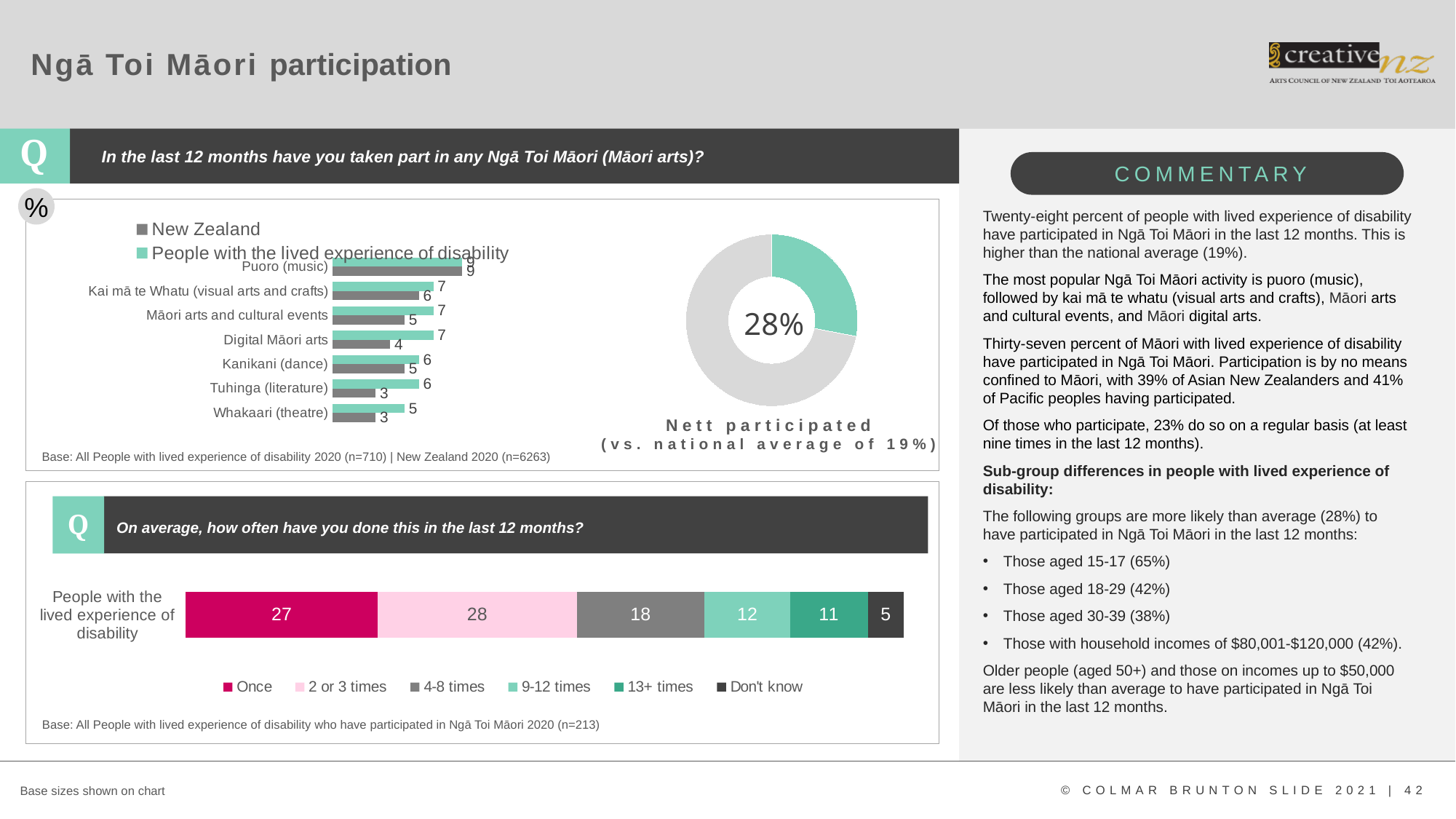
What percentage is shown in the centre of the donut chart labelled 'Nett participated'? 28% What type of chart is the bottom chart on how often people have done this in the last 12 months? Stacked bar chart In the top-left bar chart of Ngā Toi Māori activities, what is the difference between the disability value and the New Zealand value for Tuhinga (literature)? 3 In the top-left bar chart of Ngā Toi Māori activities, what is the New Zealand value for Digital Māori arts? 4 In the bottom stacked bar chart on how often people have done this, which category has the smallest value? Don't know In the top-left bar chart of Ngā Toi Māori activities, what is the value for Puoro (music) for people with the lived experience of disability? 9 In the top-left bar chart of Ngā Toi Māori activities, which activity has the lowest value for people with the lived experience of disability? Whakaari (theatre) In the bottom stacked bar chart on how often people have done this, is the value for 'Once' larger or smaller than the value for '4-8 times'? larger In the top-left bar chart of Ngā Toi Māori activities, how many activities are listed? 7 In the bottom stacked bar chart on how often people have done this, what is the value for '2 or 3 times'? 28 In the top-left bar chart of Ngā Toi Māori activities, which activity has the highest value for people with the lived experience of disability? Puoro (music) In the top-left bar chart of Ngā Toi Māori activities, how many series does the legend list? 2